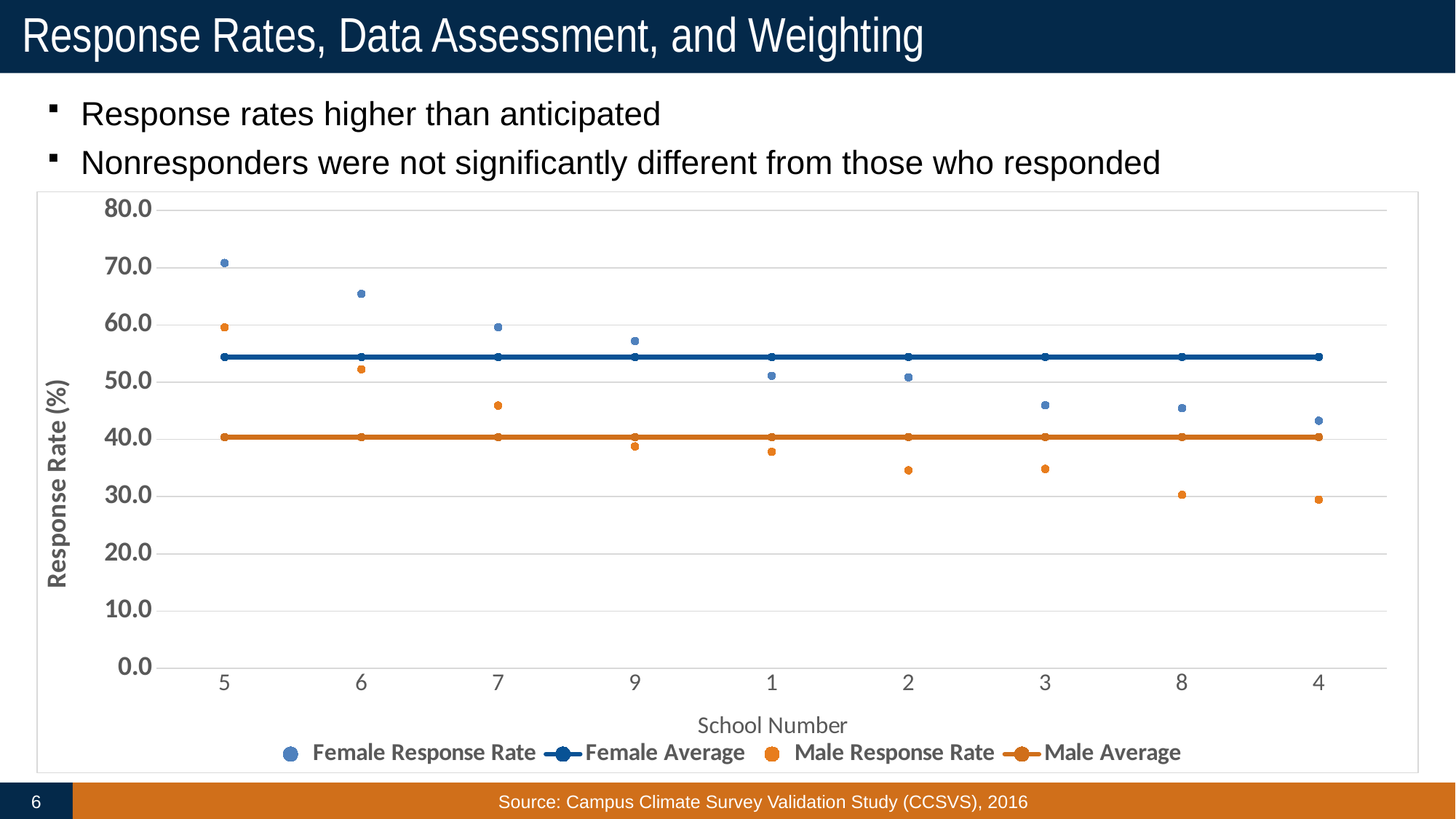
How many series does the chart legend list? 4 What kind of chart is shown on the slide? line chart At school 7, which is larger: the Female Response Rate or the Male Response Rate? Female Response Rate Is the Female Response Rate for school 6 greater or less than 60.0? greater Which school has the lowest Female Response Rate? 4 Do the Female Response Rate values rise or fall moving left to right along the x axis? fall Which school has the highest Female Response Rate? 5 Which school has the highest Male Response Rate? 5 How many schools are plotted along the x axis? 9 What is the title of the x axis? School Number Is the Male Response Rate for school 8 greater or less than 40.0? less Is the Female Average line greater or less than 50.0? greater